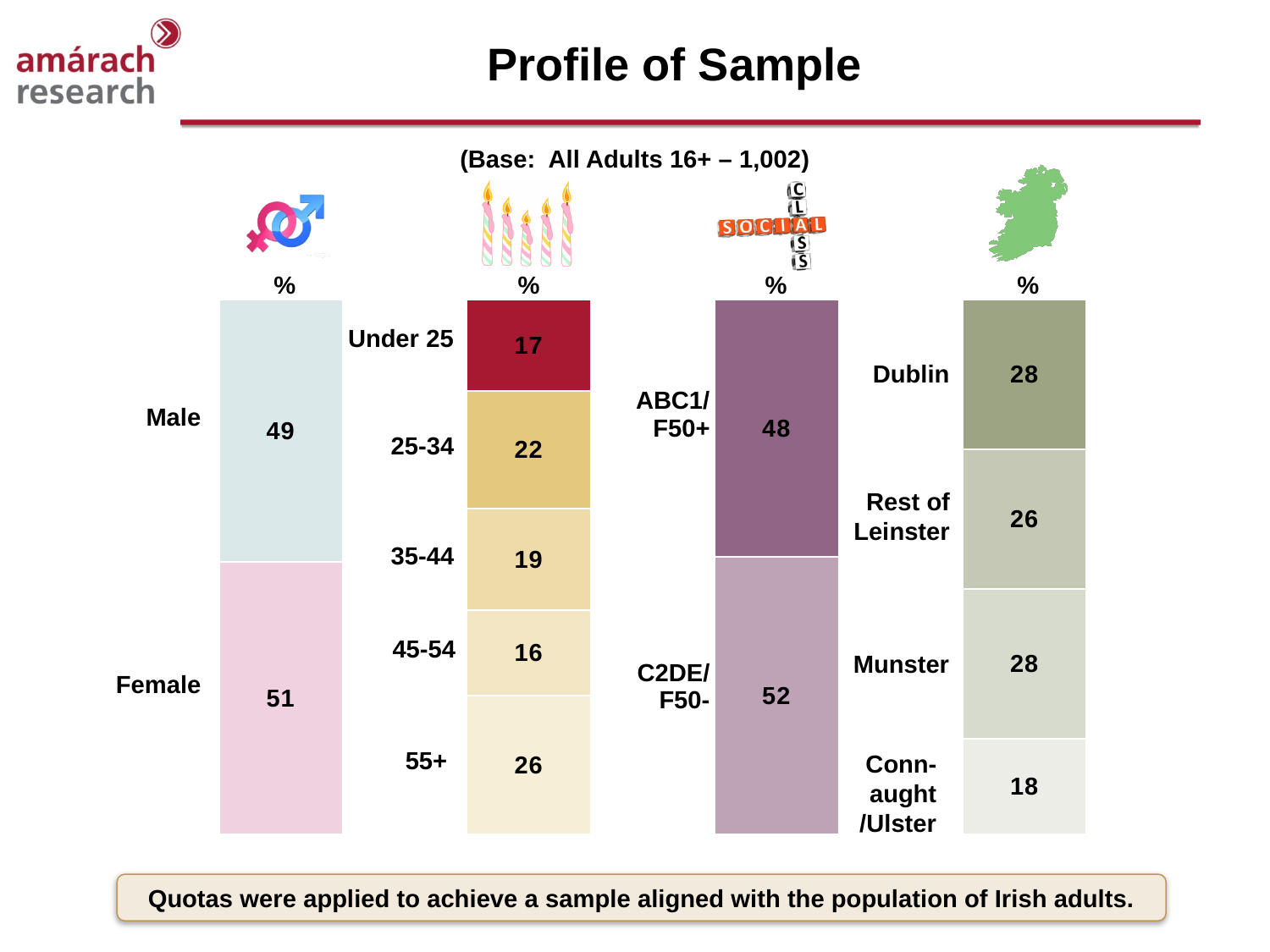
In the age chart (second bar from the left), which age group has the largest share? 55+ In the social class chart (third bar from the left), what is the value for C2DE/F50-? 52 In the region chart (fourth bar from the left), which region has the smallest share? Connaught/Ulster In the age chart (second bar from the left), which age group has the smallest share? 45-54 In the gender chart (first bar from the left), what percentage of the sample is Female? 51 What is the total of the region chart (fourth bar from the left) when all four segments are added? 100 In the social class chart (third bar from the left), which is larger, ABC1/F50+ or C2DE/F50-? C2DE/F50- In the region chart (fourth bar from the left), what is the value for Rest of Leinster? 26 In the age chart (second bar from the left), how many age groups are shown? 5 In the age chart (second bar from the left), what is the difference between the 55+ group and the Under 25 group? 9 In the age chart (second bar from the left), what is the value for the 25-34 group? 22 In the gender chart (first bar from the left), what percentage of the sample is Male? 49